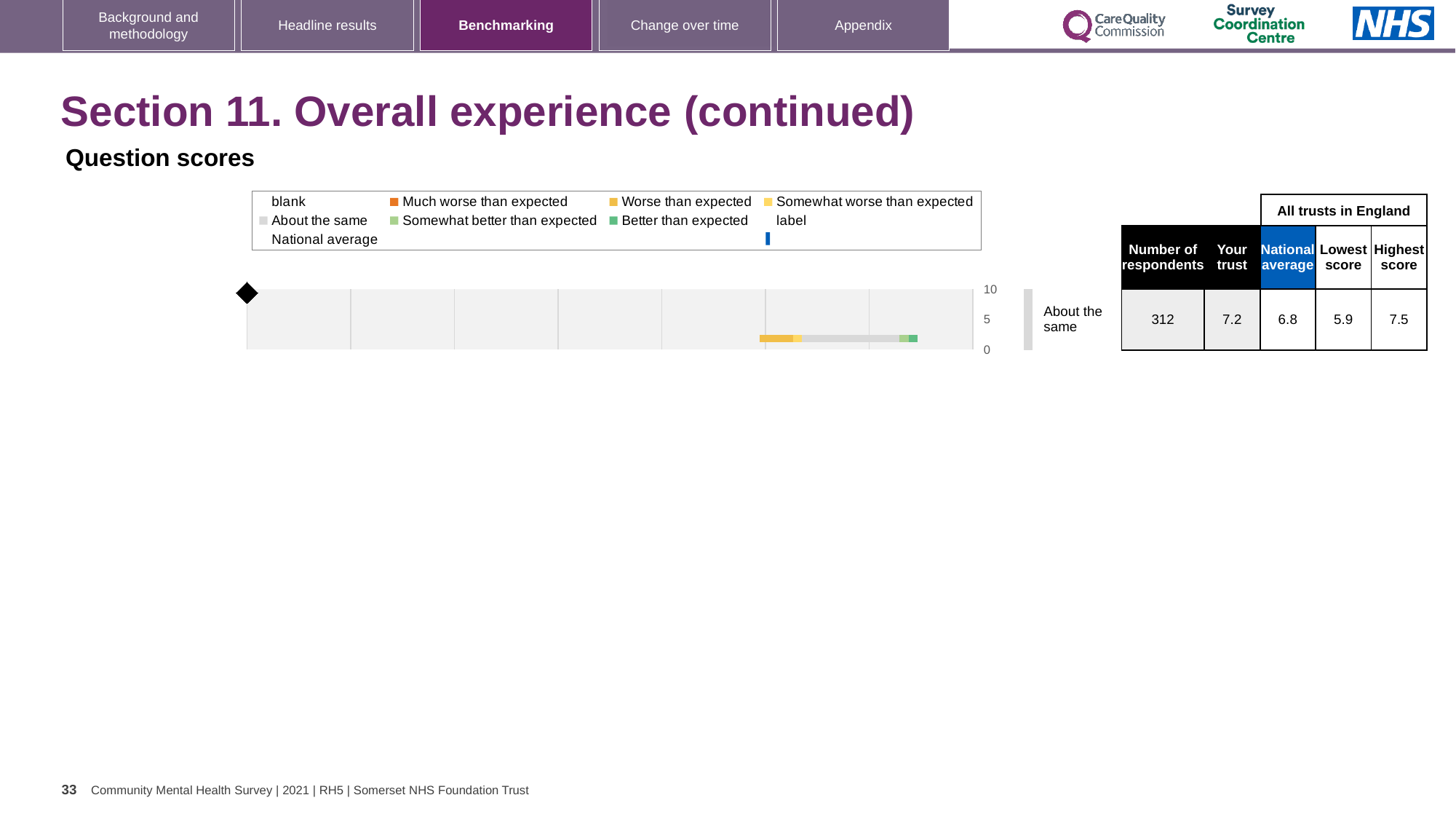
What is the difference between the Highest score and the Lowest score in the table? 1.6 In the table next to the chart, what is the Highest score among all trusts in England? 7.5 Which is larger, the 'Your trust' score or the National average score? Your trust What kind of chart is shown on the slide? bar chart What is the highest value shown on the chart's axis? 10 What is the label of the single category plotted on the chart? About the same In the table next to the chart, what is the Lowest score among all trusts in England? 5.9 In the table next to the chart, what is the 'Your trust' score for 'About the same'? 7.2 In the table next to the chart, how many respondents are listed? 312 How many categories are plotted on the chart? 1 In the table next to the chart, what is the National average score? 6.8 What is the difference between the 'Your trust' score and the National average score? 0.4